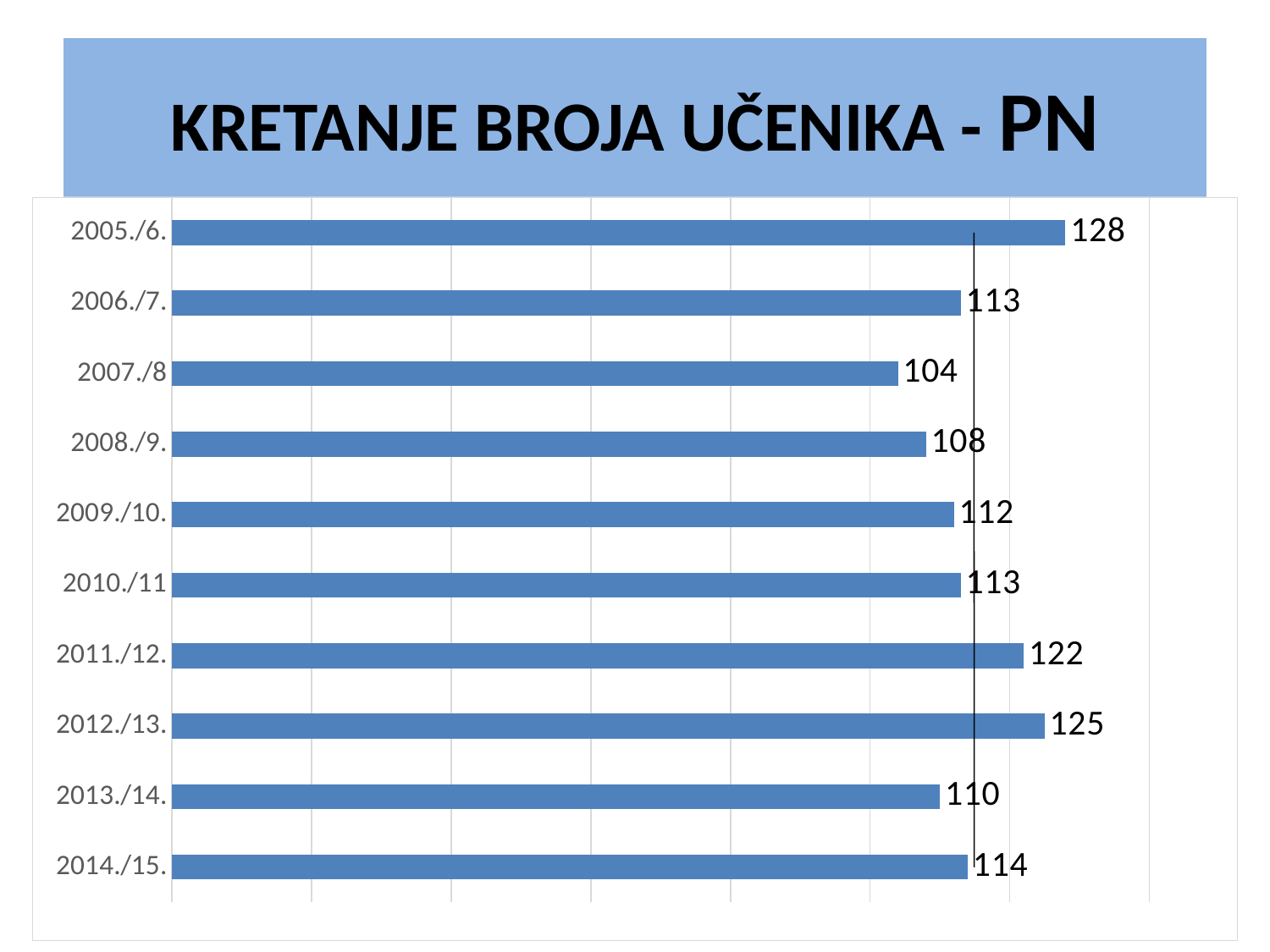
What is the difference between the values for 2012./13. and 2013./14.? 15 How many categories are shown in the chart? 10 Which category has the highest value? 2005./6. Which is larger, the value for 2011./12. or the value for 2014./15.? 2011./12. What kind of chart is shown on the slide? bar chart What is the value for 2012./13.? 125 What is the value for 2005./6.? 128 What is the value for 2013./14.? 110 What is the value for 2007./8? 104 What is the difference between the values for 2005./6. and 2007./8? 24 What is the title of the slide? KRETANJE BROJA UČENIKA - PN Which category has the lowest value? 2007./8